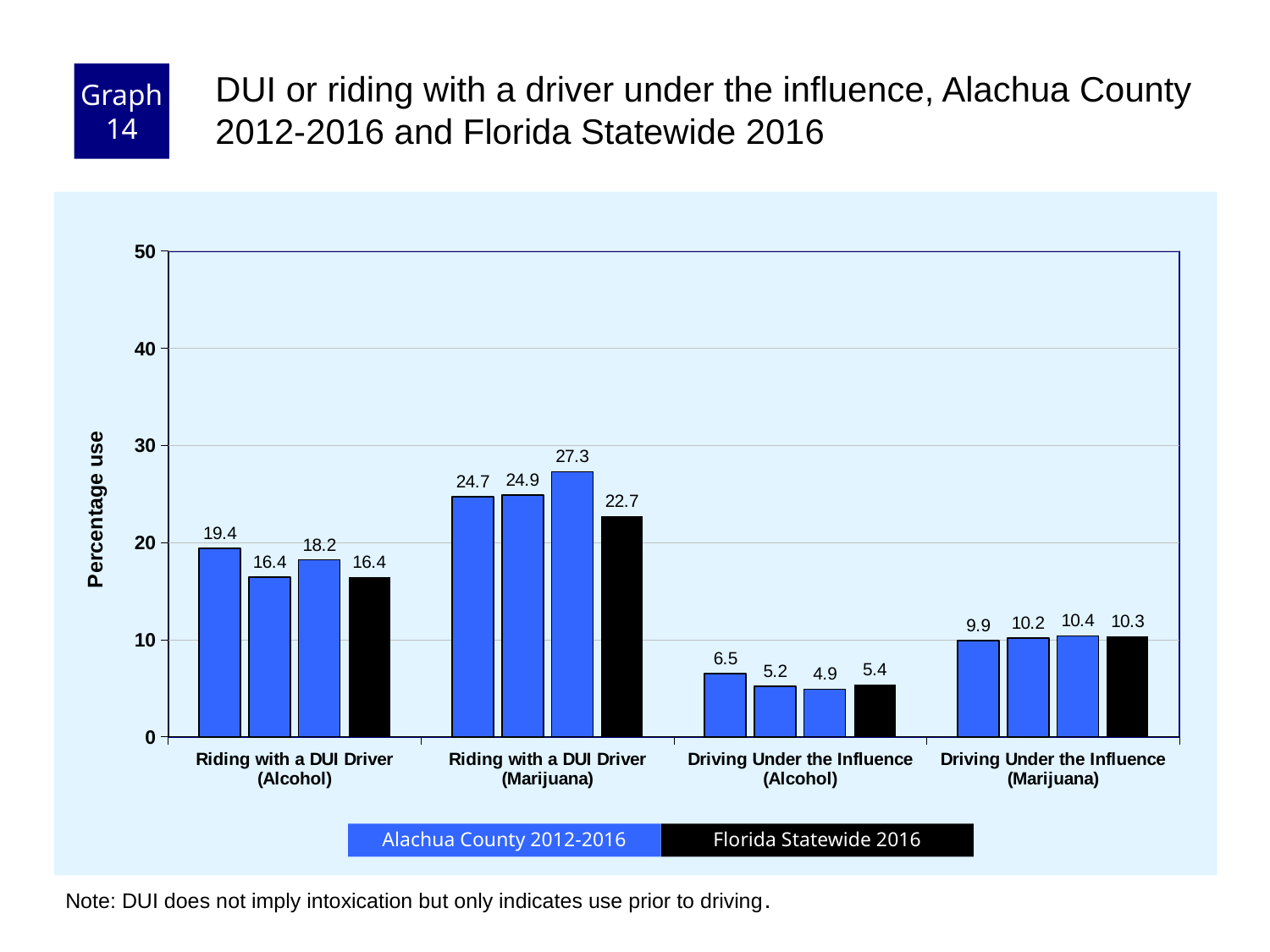
What kind of chart is shown on the slide? Bar chart What is the Florida Statewide 2016 value for Driving Under the Influence (Alcohol)? 5.4 What is the label of the y axis? Percentage use What is the value of the tallest Alachua County 2012-2016 bar for Riding with a DUI Driver (Marijuana)? 27.3 What is the value of the lowest bar in the Driving Under the Influence (Alcohol) group? 4.9 How many series does the legend list? 2 What is the Florida Statewide 2016 value for Riding with a DUI Driver (Marijuana)? 22.7 Which is larger for Riding with a DUI Driver (Alcohol): the leftmost Alachua County bar or the Florida Statewide 2016 bar? The leftmost Alachua County bar (19.4) How many categories are shown on the x axis? 4 Is the Florida Statewide 2016 value for Riding with a DUI Driver (Marijuana) greater or less than 20? greater What is the Florida Statewide 2016 value for Driving Under the Influence (Marijuana)? 10.3 What is the difference between the highest Alachua County bar (27.3) and the Florida Statewide 2016 bar (22.7) for Riding with a DUI Driver (Marijuana)? 4.6